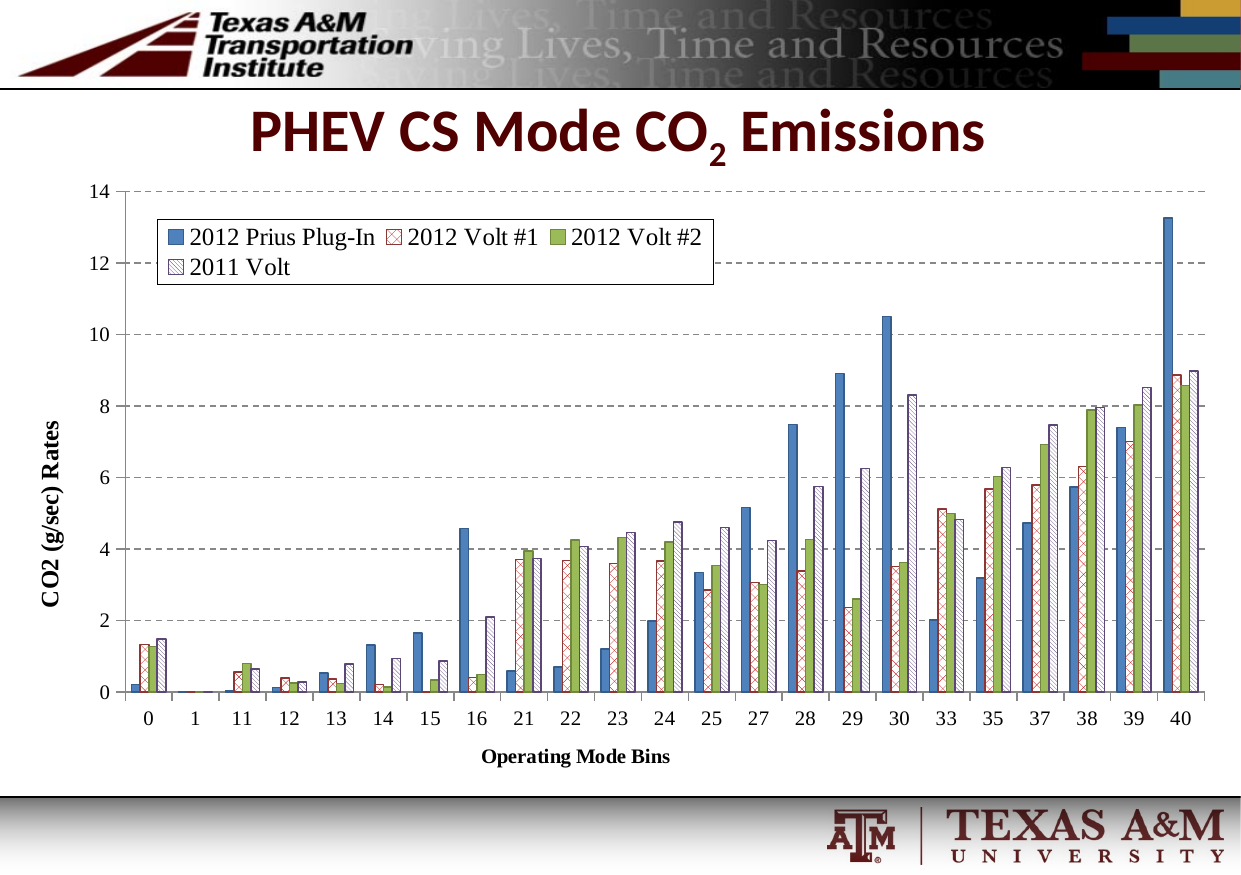
Is the 2011 Volt value for bin 30 greater or less than 8? greater At bin 21, which is larger: the 2012 Prius Plug-In or the 2012 Volt #2? 2012 Volt #2 At bin 30, which is larger: the 2012 Prius Plug-In or the 2012 Volt #1? 2012 Prius Plug-In Is the 2012 Prius Plug-In value for bin 40 greater or less than 12? greater What kind of chart is shown on the slide? bar chart How many operating mode bins are shown on the x axis? 23 Is the 2012 Prius Plug-In value for bin 30 greater or less than 10? greater What is the title of the y axis? CO2 (g/sec) Rates In which operating mode bin does the 2012 Prius Plug-In have its highest CO2 rate? 40 What is the title of the x axis? Operating Mode Bins How many series does the legend list? 4